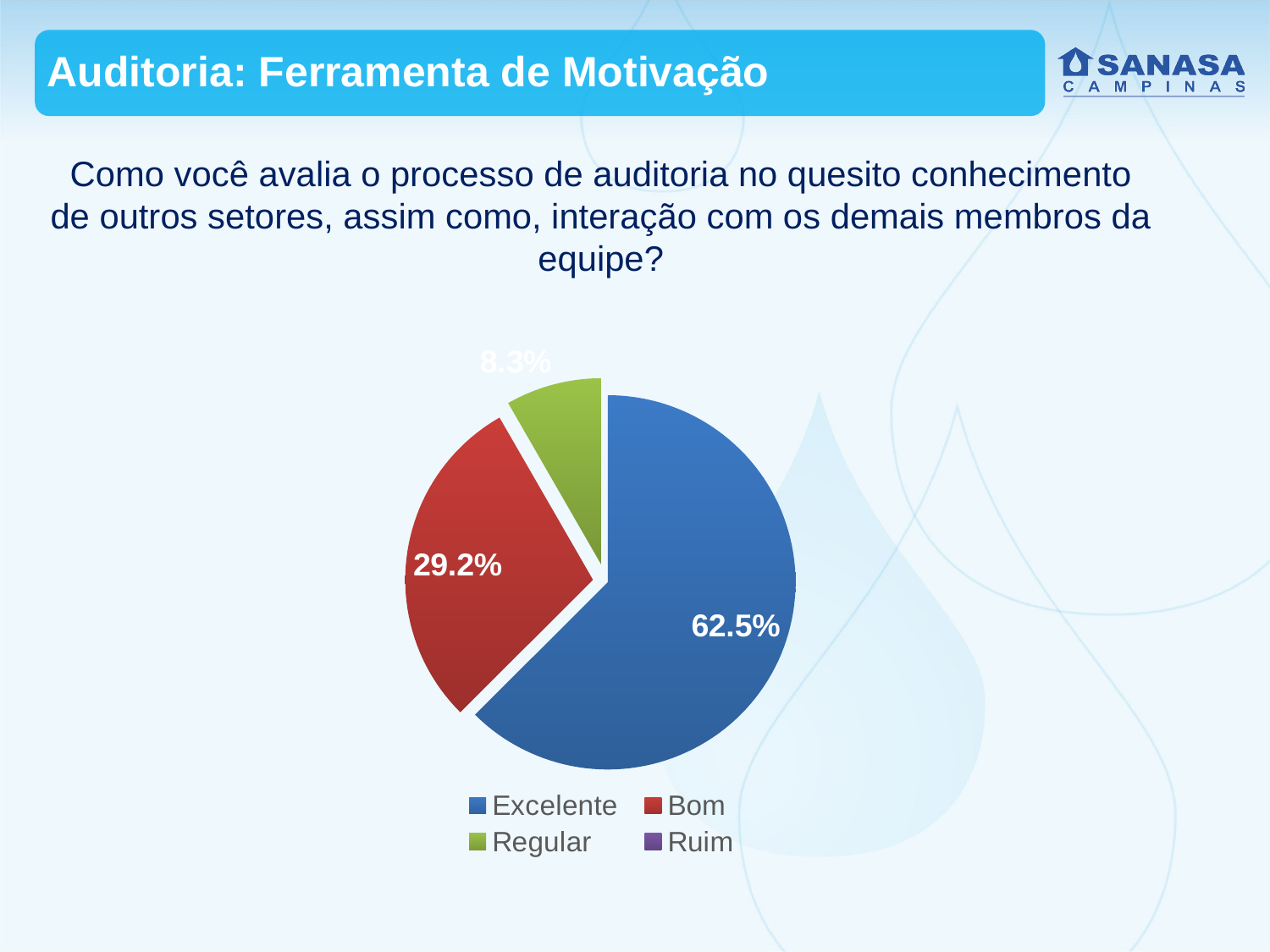
What is the difference in percentage points between the Excelente and Bom shares? 33.3% Which is larger, the share for Bom or the share for Regular? Bom What percentage of respondents rated the audit process as Excelente? 62.5% What kind of chart is shown on the slide? pie chart What colour is the Excelente slice of the pie? blue Which legend entry is shown in green? Regular How many entries does the legend list? 4 What percentage of respondents rated the audit process as Regular? 8.3% What is the difference in percentage points between the Bom and Regular shares? 20.9% Which rating category has the largest share of the pie? Excelente Among the slices with printed labels, which rating category has the smallest share? Regular What percentage of respondents rated the audit process as Bom? 29.2%